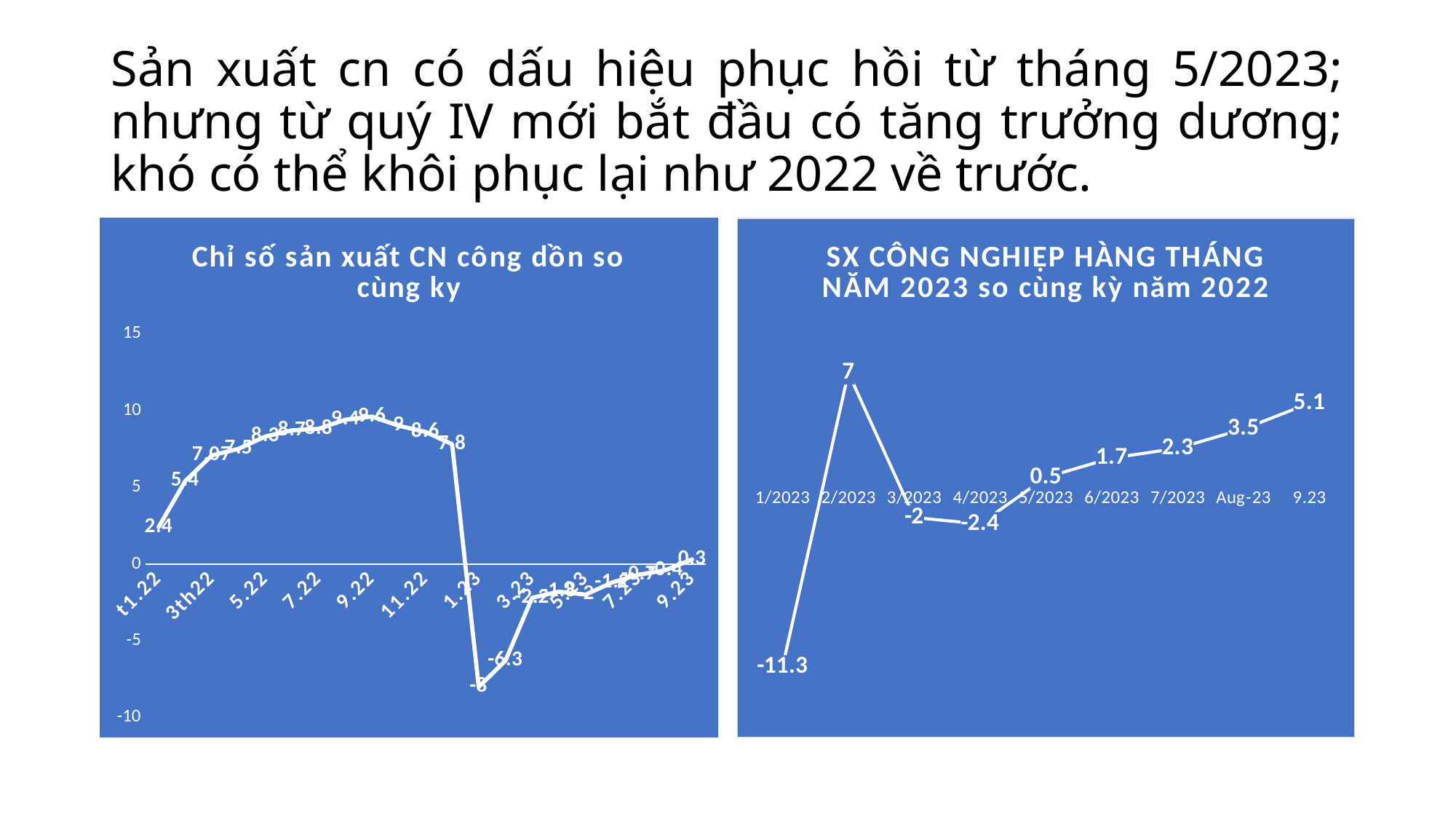
In the right chart (SX CÔNG NGHIỆP HÀNG THÁNG NĂM 2023 so cùng kỳ năm 2022), what is the difference between the values for Aug-23 and 7/2023? 1.2 In the right chart (SX CÔNG NGHIỆP HÀNG THÁNG NĂM 2023 so cùng kỳ năm 2022), what is the value for 1/2023? -11.3 In the right chart (SX CÔNG NGHIỆP HÀNG THÁNG NĂM 2023 so cùng kỳ năm 2022), what is the value for 9.23? 5.1 In the left chart (Chỉ số sản xuất CN công dồn so cùng ky), what is the value for t1.22? 2.4 In the right chart (SX CÔNG NGHIỆP HÀNG THÁNG NĂM 2023 so cùng kỳ năm 2022), what is the value for 2/2023? 7 In the right chart (SX CÔNG NGHIỆP HÀNG THÁNG NĂM 2023 so cùng kỳ năm 2022), which month has the highest value? 2/2023 In the right chart (SX CÔNG NGHIỆP HÀNG THÁNG NĂM 2023 so cùng kỳ năm 2022), which month has the lowest value? 1/2023 In the right chart (SX CÔNG NGHIỆP HÀNG THÁNG NĂM 2023 so cùng kỳ năm 2022), do the values rise or fall from 4/2023 to 9.23? rise In the right chart (SX CÔNG NGHIỆP HÀNG THÁNG NĂM 2023 so cùng kỳ năm 2022), how many months are plotted? 9 What type of chart is the left chart (Chỉ số sản xuất CN công dồn so cùng ky)? line chart In the left chart (Chỉ số sản xuất CN công dồn so cùng ky), what is the lowest value plotted? -8 In the right chart (SX CÔNG NGHIỆP HÀNG THÁNG NĂM 2023 so cùng kỳ năm 2022), which is larger, the value for 3/2023 or 4/2023? 3/2023